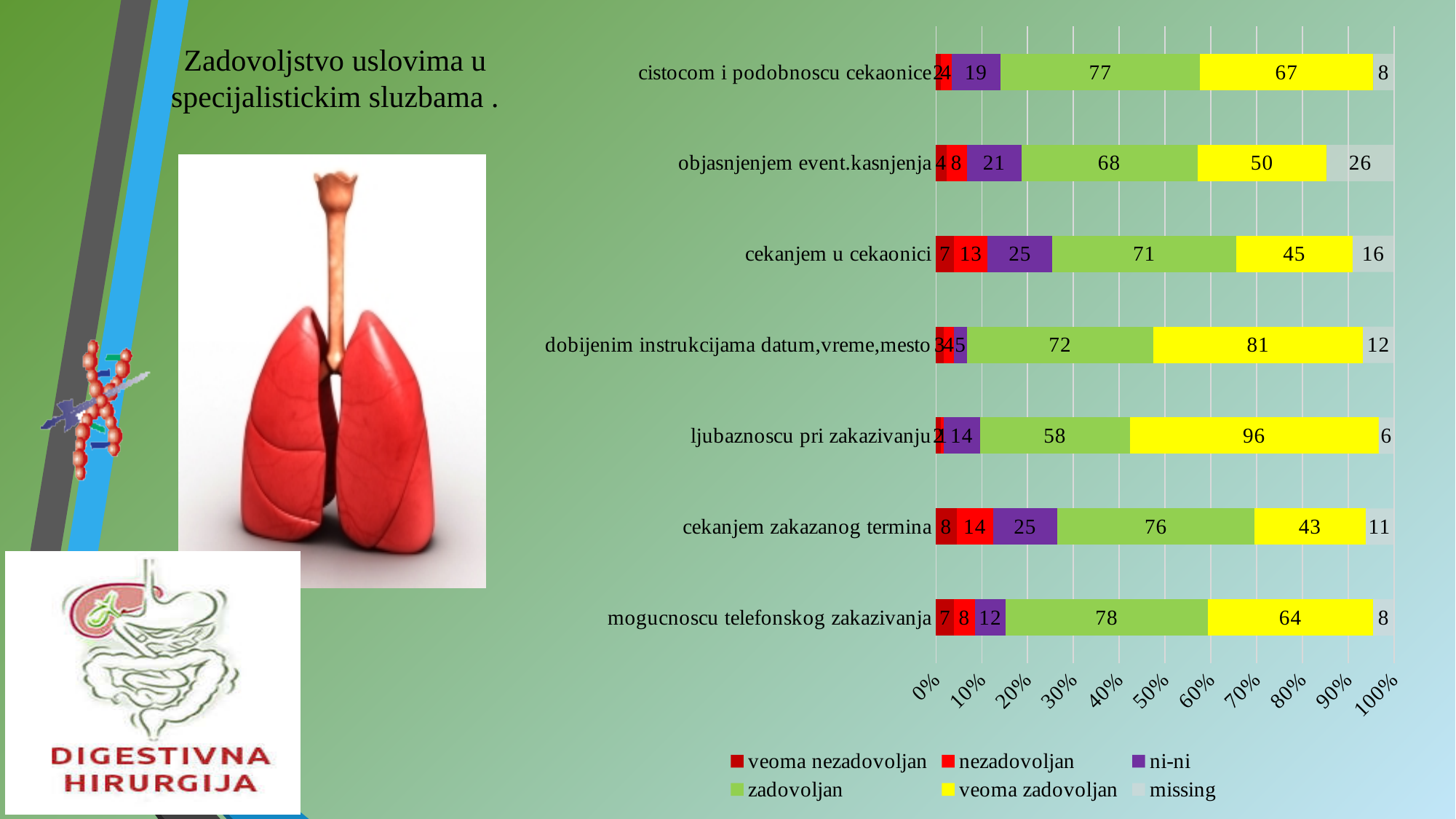
What is the 'missing' value for 'objasnjenjem event.kasnjenja'? 26 Which category has the lowest 'veoma zadovoljan' value? cekanjem zakazanog termina What is the total of all segments in the bar for 'cekanjem u cekaonici'? 177 What is the 'veoma zadovoljan' value for 'ljubaznoscu pri zakazivanju'? 96 Which category has the highest 'veoma zadovoljan' value? ljubaznoscu pri zakazivanju What is the 'ni-ni' value for 'cekanjem u cekaonici'? 25 What is the 'zadovoljan' value for 'mogucnoscu telefonskog zakazivanja'? 78 How many series does the legend list? 6 Which is larger: the 'zadovoljan' value for 'cekanjem zakazanog termina' or for 'ljubaznoscu pri zakazivanju'? cekanjem zakazanog termina How many categories are shown on the chart? 7 What type of chart is shown on the slide? stacked bar chart What is the difference between the 'veoma zadovoljan' values for 'dobijenim instrukcijama datum,vreme,mesto' and 'cekanjem u cekaonici'? 36